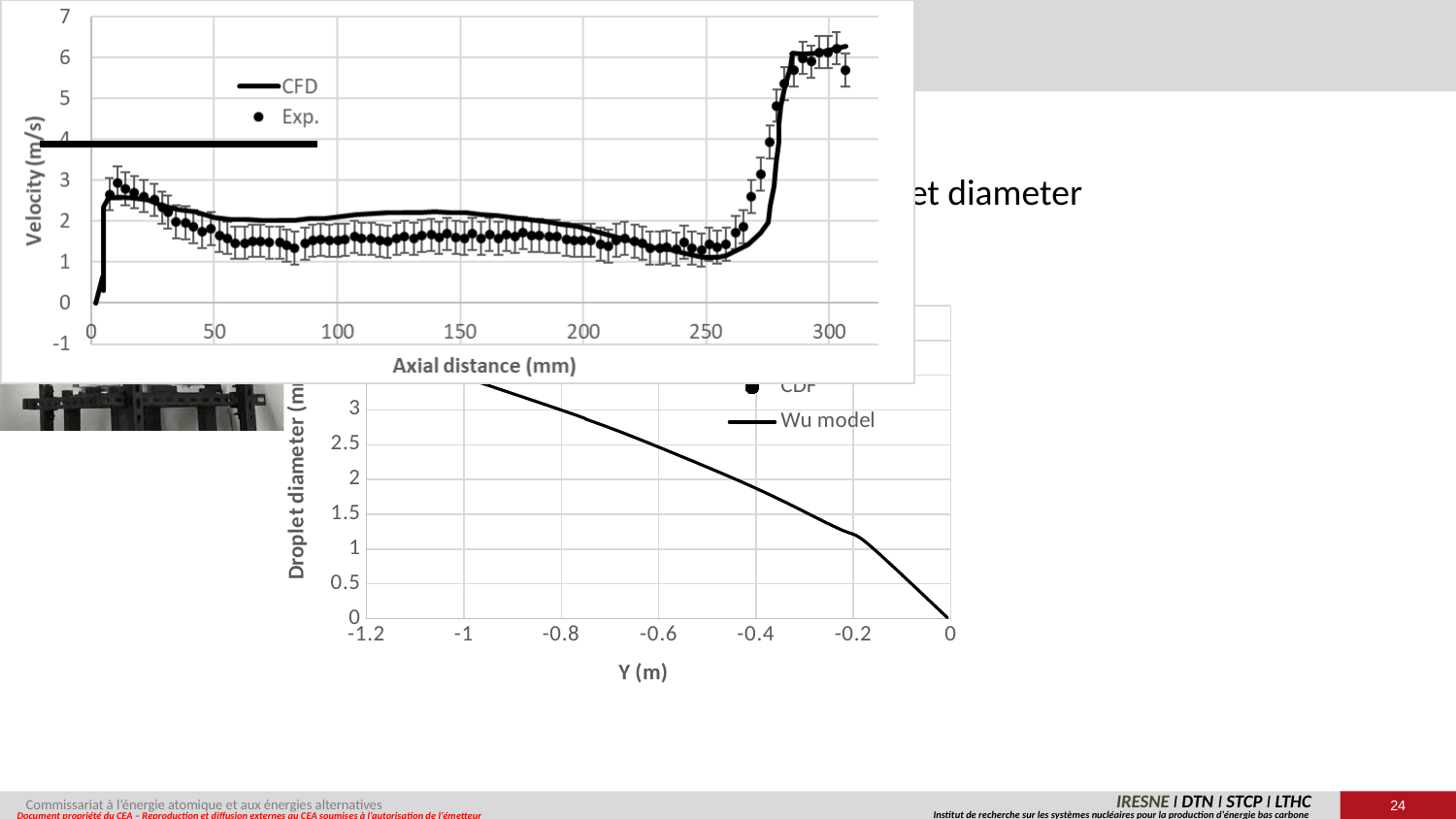
On the top-left chart (Velocity vs Axial distance), is the Exp. velocity at an axial distance of 250 mm greater or less than 2? less On the top-left chart (Velocity vs Axial distance), does the velocity rise or fall sharply between axial distances of 260 mm and 290 mm? rise On the top-left chart (Velocity vs Axial distance), what are the two legend entries? CFD and Exp. On the top-left chart (Velocity vs Axial distance), what is the label of the x axis? Axial distance (mm) On the bottom-right chart (Droplet diameter vs Y), what kind of chart is it? line chart On the top-left chart (Velocity vs Axial distance), is the Exp. velocity at an axial distance of 300 mm greater or less than 5? greater On the bottom-right chart (Droplet diameter vs Y), is the Wu model value at Y = -0.2 greater or less than 1? greater On the top-left chart (Velocity vs Axial distance), how many series does the legend list? 2 On the bottom-right chart (Droplet diameter vs Y), does the Wu model line rise or fall as Y increases from -1.2 to 0? fall On the bottom-right chart (Droplet diameter vs Y), what is the label of the x axis? Y (m)